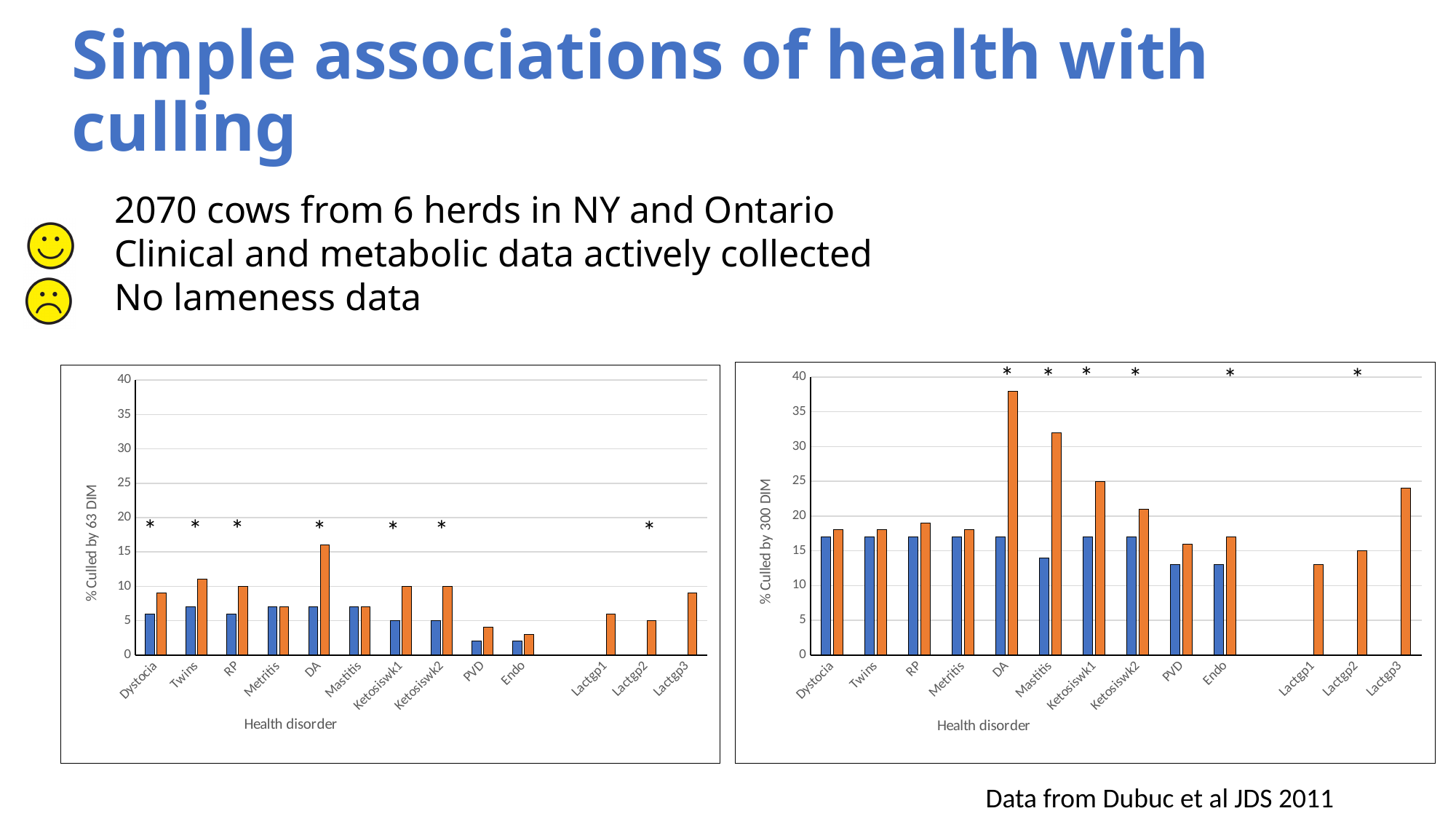
In the right chart, is the orange bar for DA greater or less than 35? greater In the right chart, which orange bar is taller, DA or Mastitis? DA What is the y-axis label of the right chart? % Culled by 300 DIM In the right chart, is the orange bar for Lactgp1 greater or less than 15? less In the right chart, is the orange bar for Lactgp3 greater or less than 20? greater In the right chart, which health disorder has the tallest orange bar? DA What kind of chart is the left chart on the slide? bar chart In the left chart, which orange bar is taller, DA or Twins? DA How many health disorder categories are shown on the x axis of the right chart? 13 In the left chart, which health disorder has the tallest orange bar? DA